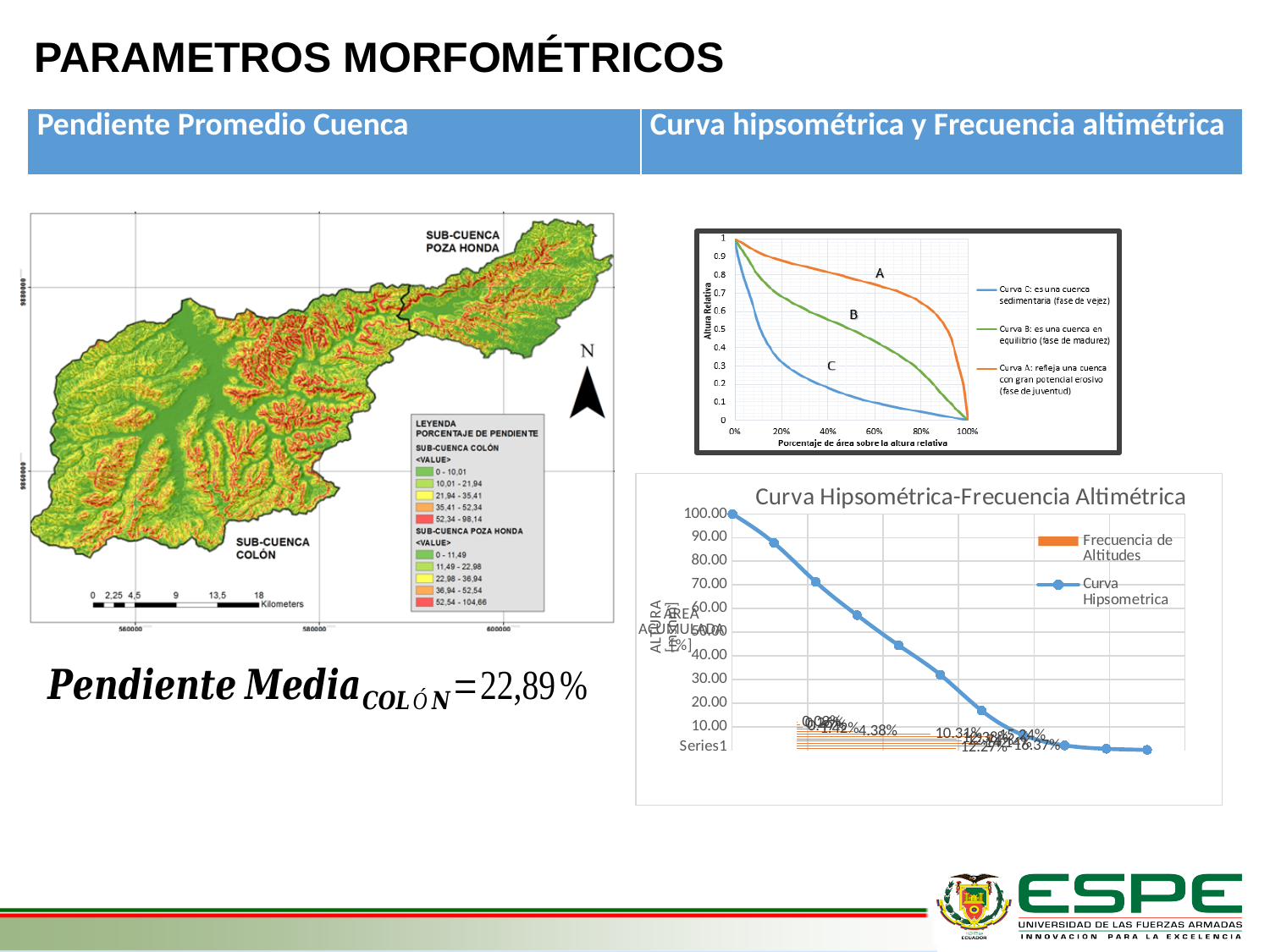
In the upper-right reference chart with curves A, B and C, which curve is lowest at 60% on the x axis? C In the chart titled 'Curva Hipsométrica-Frecuencia Altimétrica', what are the two legend entries? Frecuencia de Altitudes; Curva Hipsometrica In the upper-right reference chart with curves A, B and C, is the value of curve C at 20% greater or less than 0.4? less In the upper-right reference chart with curves A, B and C, which curve is highest at 40% on the x axis? A In the chart titled 'Curva Hipsométrica-Frecuencia Altimétrica', how many series does the legend list? 2 In the chart titled 'Curva Hipsométrica-Frecuencia Altimétrica', is the seventh point of the Curva Hipsometrica line greater or less than 20.00? less In the chart titled 'Curva Hipsométrica-Frecuencia Altimétrica', which series is drawn as a line with markers? Curva Hipsometrica In the chart titled 'Curva Hipsométrica-Frecuencia Altimétrica', what is the value of the first (leftmost) point of the Curva Hipsometrica line? 100.00 In the chart titled 'Curva Hipsométrica-Frecuencia Altimétrica', is the fourth point of the Curva Hipsometrica line greater or less than 60.00? less In the upper-right reference chart with curves A, B and C, how many curves does the legend list? 3 In the chart titled 'Curva Hipsométrica-Frecuencia Altimétrica', does the Curva Hipsometrica line rise or fall from left to right? fall